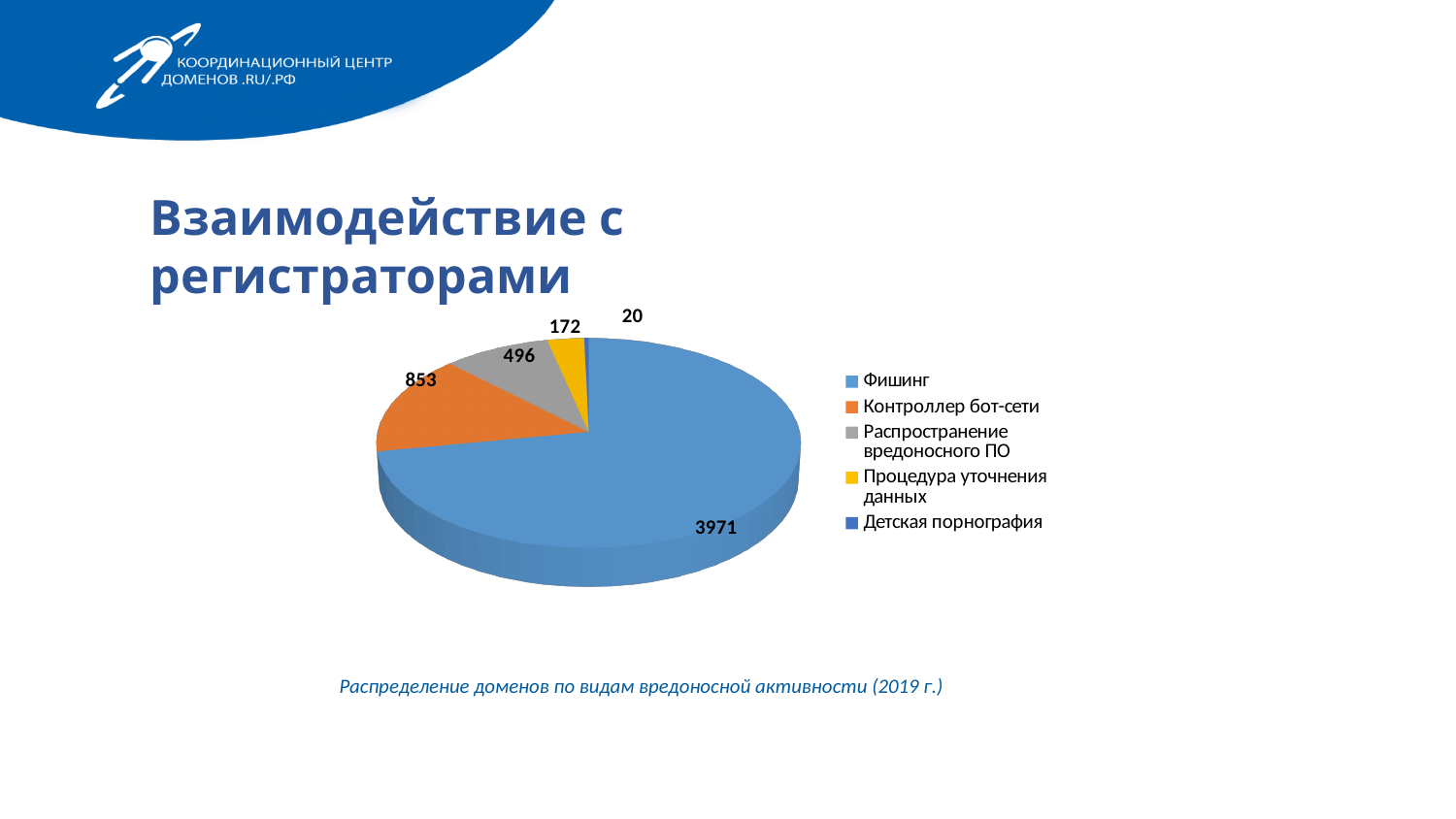
Which is larger: Распространение вредоносного ПО or Процедура уточнения данных? Распространение вредоносного ПО What is the value for Процедура уточнения данных in the pie chart? 172 What is the difference between the values for Контроллер бот-сети and Распространение вредоносного ПО? 357 What kind of chart is shown on the slide? Pie chart How many categories does the pie chart show? 5 What is the value for Детская порнография in the pie chart? 20 What is the value for Распространение вредоносного ПО in the pie chart? 496 Which category has the smallest slice in the pie chart? Детская порнография What is the value for Фишинг in the pie chart? 3971 Which category has the largest slice in the pie chart? Фишинг What is the value for Контроллер бот-сети in the pie chart? 853 What is the difference between the values for Фишинг and Контроллер бот-сети? 3118